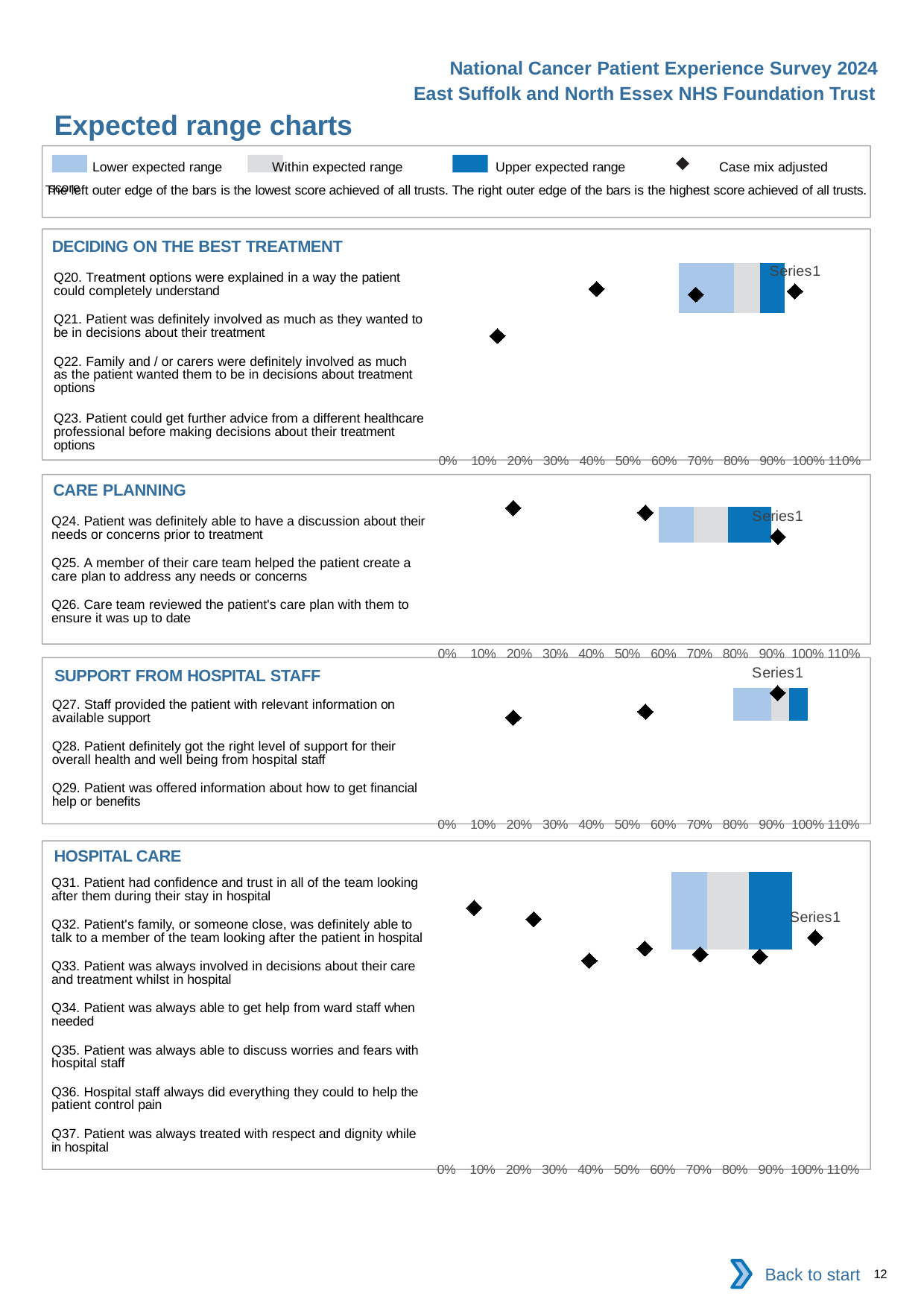
In the 'DECIDING ON THE BEST TREATMENT' chart, how many questions (categories) are listed? 4 What kind of chart is used in the 'HOSPITAL CARE' section? Bar chart According to the legend, what does the diamond marker represent? Case mix adjusted score In the 'HOSPITAL CARE' chart, how many questions (categories) are listed? 7 In the 'CARE PLANNING' chart, how many questions (categories) are listed? 3 In the 'DECIDING ON THE BEST TREATMENT' chart, what is the first question listed? Q20. Treatment options were explained in a way the patient could completely understand In the 'HOSPITAL CARE' chart, what is the last question listed? Q37. Patient was always treated with respect and dignity while in hospital How many entries does the shared legend at the top of the slide list? 4 In the 'CARE PLANNING' chart, what is the highest tick label shown on the x axis? 110%